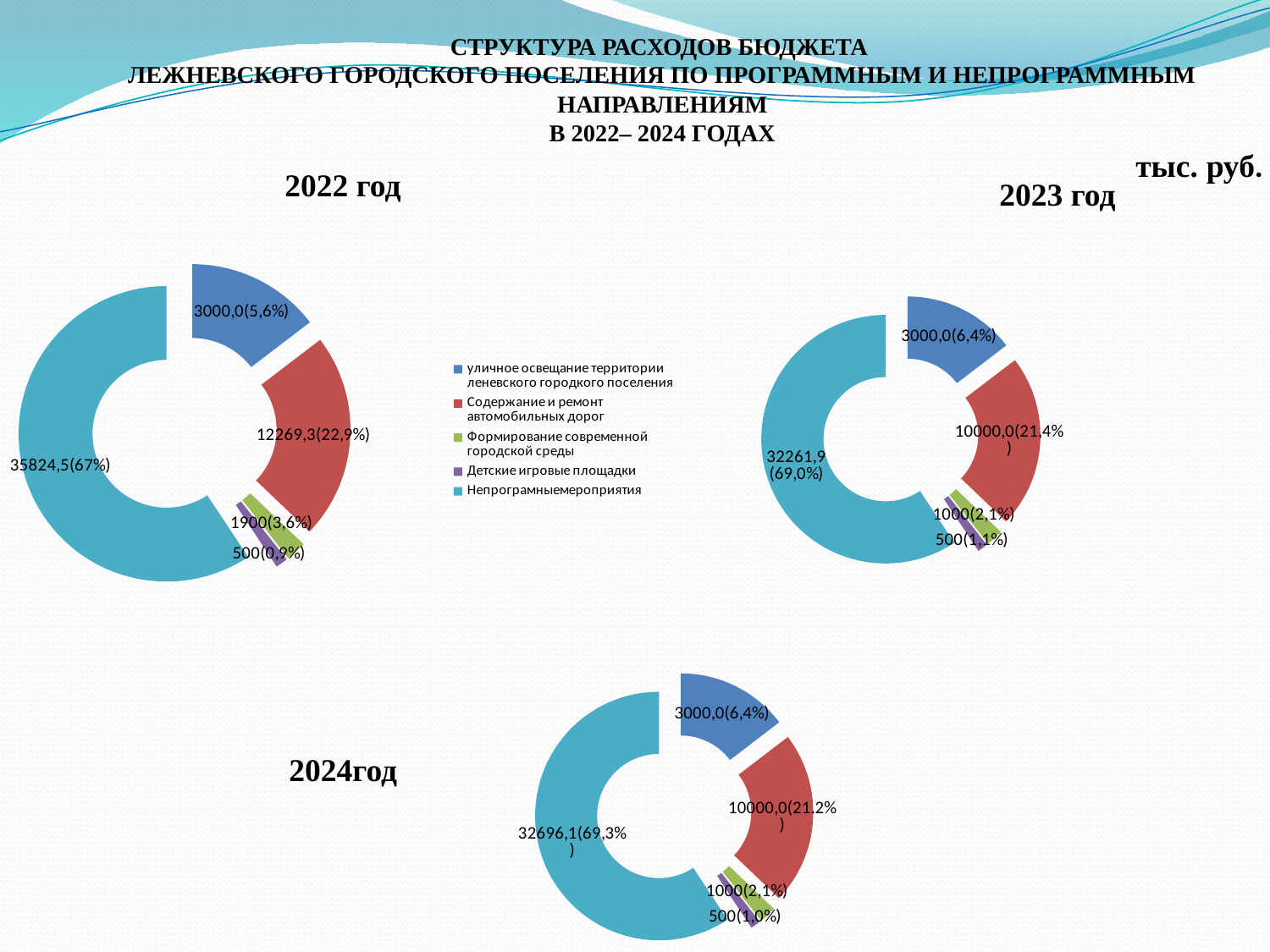
What unit is stated for the values on the slide? тыс. руб. In the 2022 год chart, what is the value shown for Содержание и ремонт автомобильных дорог? 12269,3(22,9%) How many slices does the 2023 год chart have? 5 How many series does the legend list? 5 In the 2024 год chart, which category has the largest slice? Непрограмные мероприятия In the 2024 год chart, what is the value shown for Содержание и ремонт автомобильных дорог? 10000,0(21,2%) What type of chart is used for the 2022 год chart? doughnut (pie) chart In the 2023 год chart, which is larger: уличное освещение территории or Формирование современной городской среды? уличное освещение территории In the 2022 год chart, what is the value shown for Непрограмные мероприятия? 35824,5(67%) In the 2023 год chart, what share does Непрограмные мероприятия have? 69,0% In the 2022 год chart, what is the difference between the values for Формирование современной городской среды and Детские игровые площадки? 1400 In the 2022 год chart, which category has the smallest slice? Детские игровые площадки